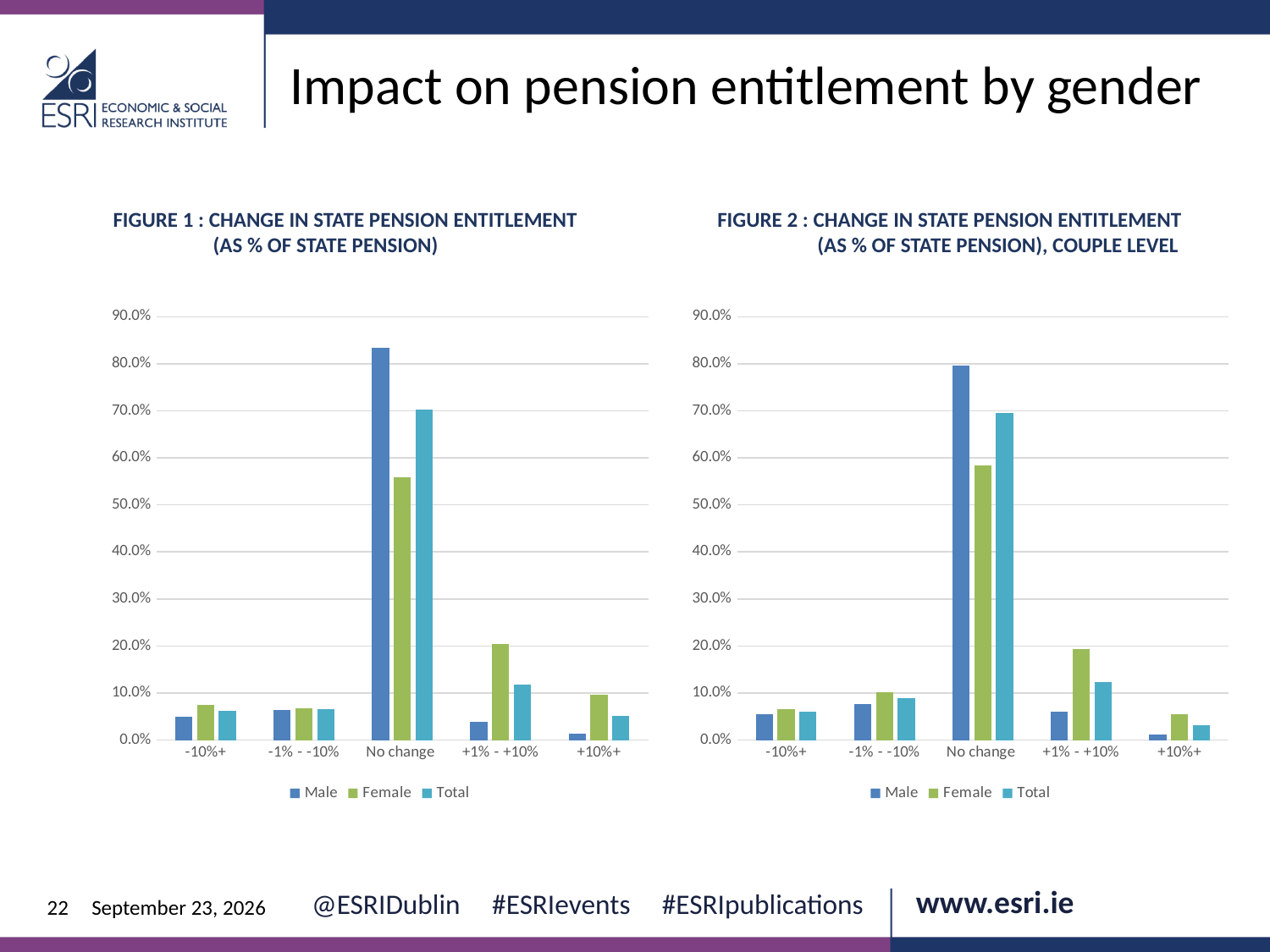
In Figure 1, is the Female value for No change greater or less than 60.0%? less In Figure 2, is the Female value for +1% - +10% greater or less than 10.0%? greater In Figure 1, which category has the highest value for the Male series? No change In Figure 2, is the Male value for No change greater or less than 70.0%? greater How many series does the legend list in Figure 1? 3 What kind of chart is Figure 2? Bar chart In Figure 1, which is larger for the +1% - +10% category, the Male value or the Female value? Female What is the title of the chart on the right of the slide? FIGURE 2 : CHANGE IN STATE PENSION ENTITLEMENT (AS % OF STATE PENSION), COUPLE LEVEL In Figure 1, which category has the lowest value for the Male series? +10%+ How many categories are shown on the x axis of Figure 2? 5 In Figure 2, which is larger for the No change category, the Female value or the Total value? Total